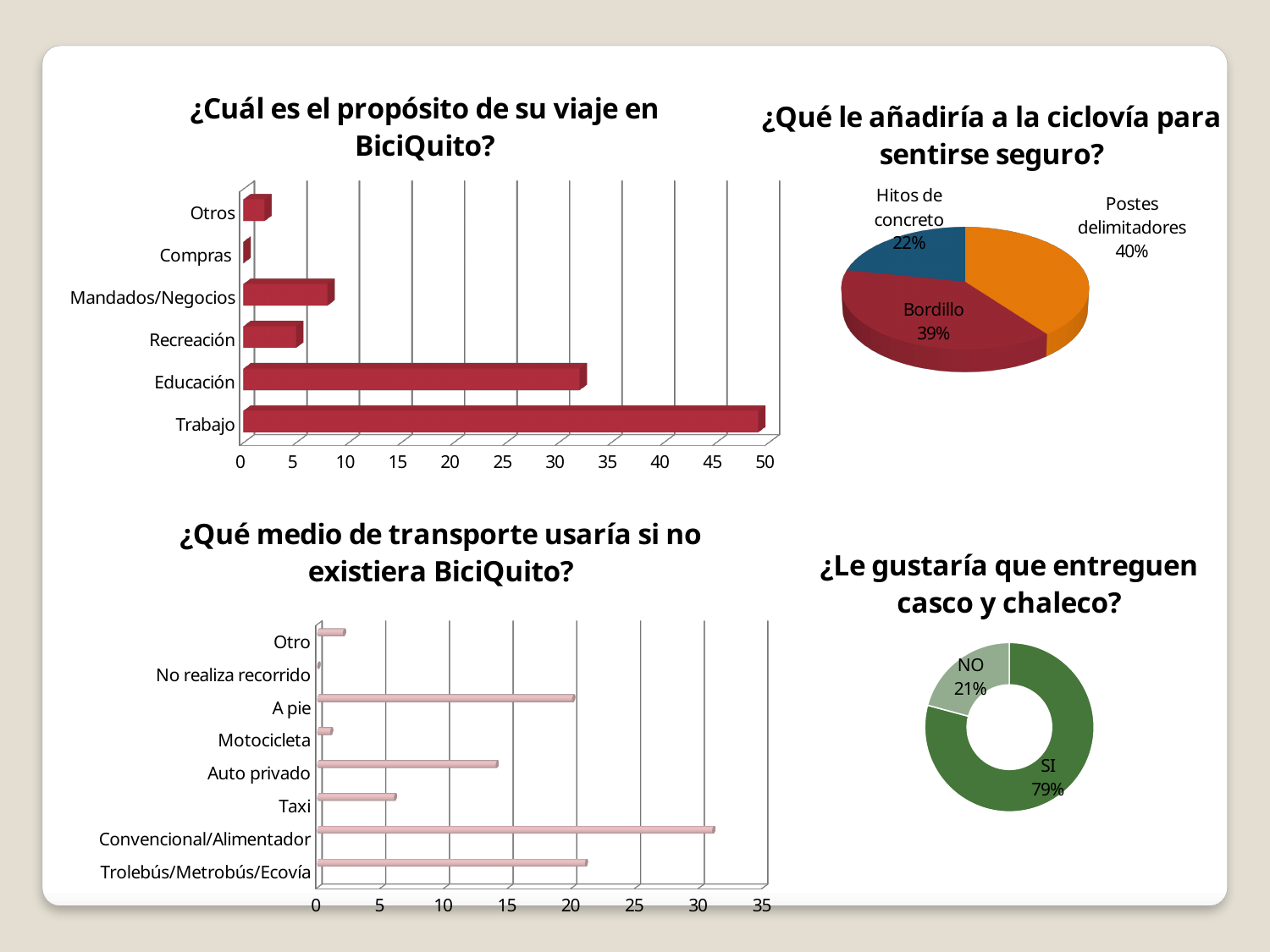
What kind of chart is '¿Cuál es el propósito de su viaje en BiciQuito?'? Bar chart In the chart '¿Qué medio de transporte usaría si no existiera BiciQuito?', which is larger, Taxi or Auto privado? Auto privado In the chart '¿Cuál es el propósito de su viaje en BiciQuito?', which category has the highest value? Trabajo In the chart '¿Cuál es el propósito de su viaje en BiciQuito?', is the value for Trabajo greater or less than 45? greater How many categories are shown in the chart '¿Qué medio de transporte usaría si no existiera BiciQuito?'? 8 In the chart '¿Cuál es el propósito de su viaje en BiciQuito?', is the value for Mandados/Negocios greater or less than 10? less In the chart '¿Le gustaría que entreguen casco y chaleco?', what percentage answered SI? 79% In the pie chart '¿Qué le añadiría a la ciclovía para sentirse seguro?', what share is Postes delimitadores? 40% How many categories are shown in the chart '¿Cuál es el propósito de su viaje en BiciQuito?'? 6 In the pie chart '¿Qué le añadiría a la ciclovía para sentirse seguro?', which slice is the smallest? Hitos de concreto In the chart '¿Qué medio de transporte usaría si no existiera BiciQuito?', which category has the highest value? Convencional/Alimentador In the pie chart '¿Qué le añadiría a la ciclovía para sentirse seguro?', what is the difference between Postes delimitadores and Hitos de concreto? 18%